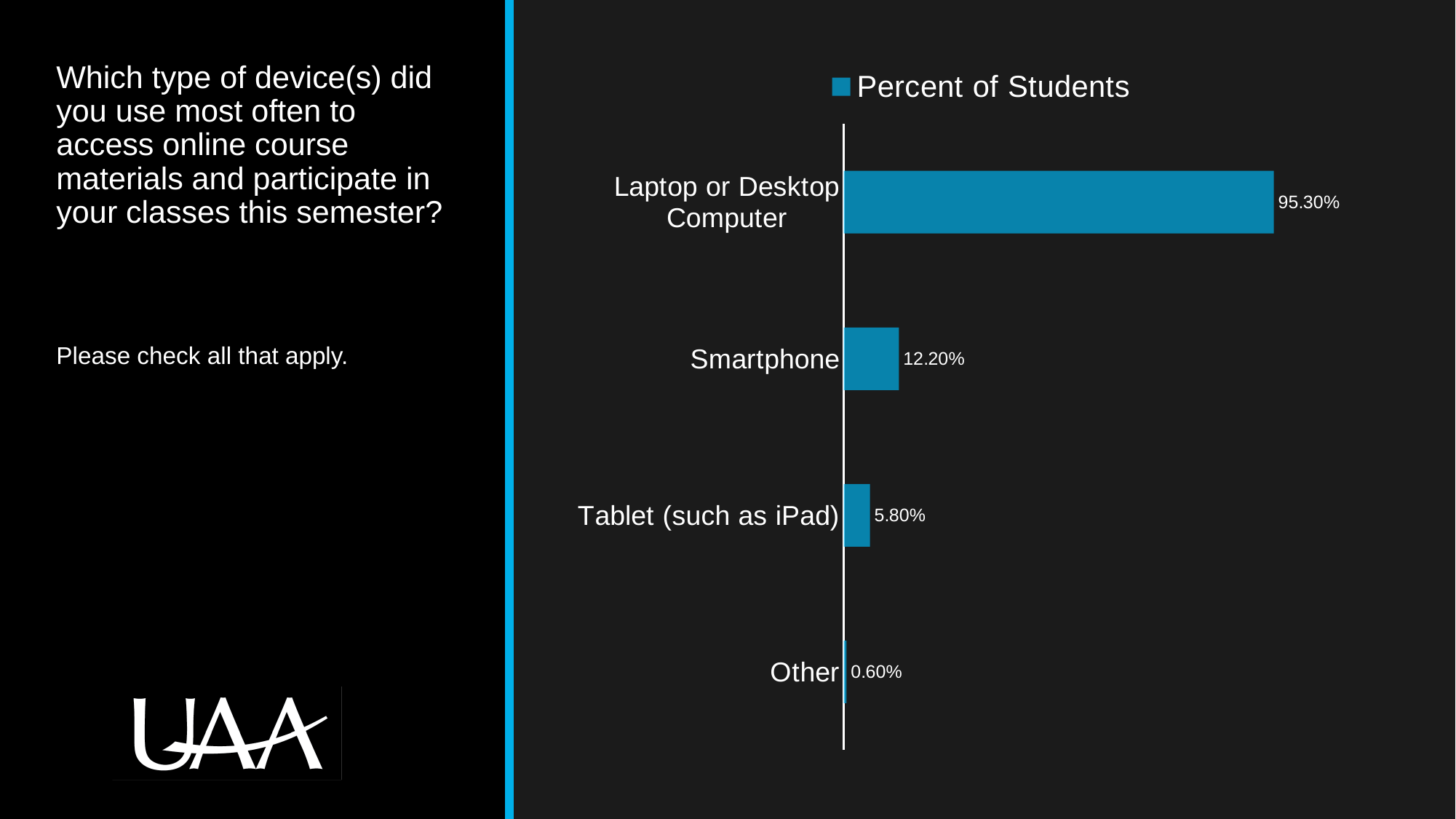
What is the difference between the Smartphone value and the Tablet (such as iPad) value? 6.40% What is the value shown for Smartphone? 12.20% Which device category has the lowest percent of students? Other How many series does the legend list? 1 What kind of chart is shown on the slide? Bar chart How many device categories are shown in the chart? 4 What is the value shown for Other? 0.60% Which is larger, the value for Smartphone or the value for Tablet (such as iPad)? Smartphone What is the difference between the Laptop or Desktop Computer value and the Smartphone value? 83.10% What percent of students is shown for Tablet (such as iPad)? 5.80% What percent of students reported using a Laptop or Desktop Computer? 95.30% Which device category has the highest percent of students? Laptop or Desktop Computer